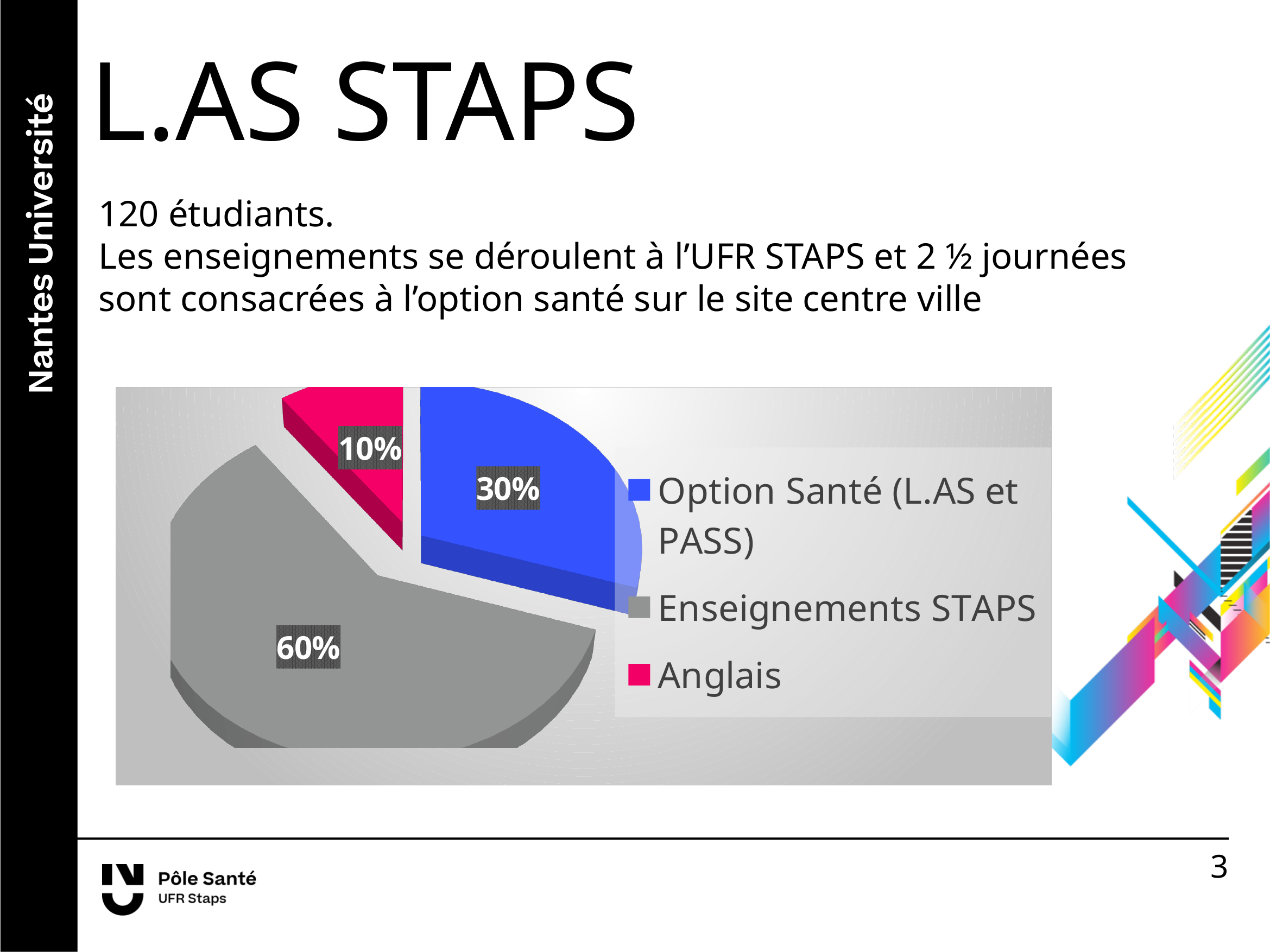
What share of the pie does Anglais represent? 10% What share of the pie does Option Santé (L.AS et PASS) represent? 30% What colour is the slice for Anglais? Pink Which is larger, the slice for Option Santé (L.AS et PASS) or the slice for Anglais? Option Santé (L.AS et PASS) Which category has the smallest slice of the pie? Anglais What colour is the slice for Option Santé (L.AS et PASS)? Blue What is the difference in percentage points between Enseignements STAPS and Option Santé (L.AS et PASS)? 30 What is the difference in percentage points between Option Santé (L.AS et PASS) and Anglais? 20 What kind of chart is shown on the slide? Pie chart Which category has the largest slice of the pie? Enseignements STAPS How many categories does the pie chart show? 3 What share of the pie does Enseignements STAPS represent? 60%